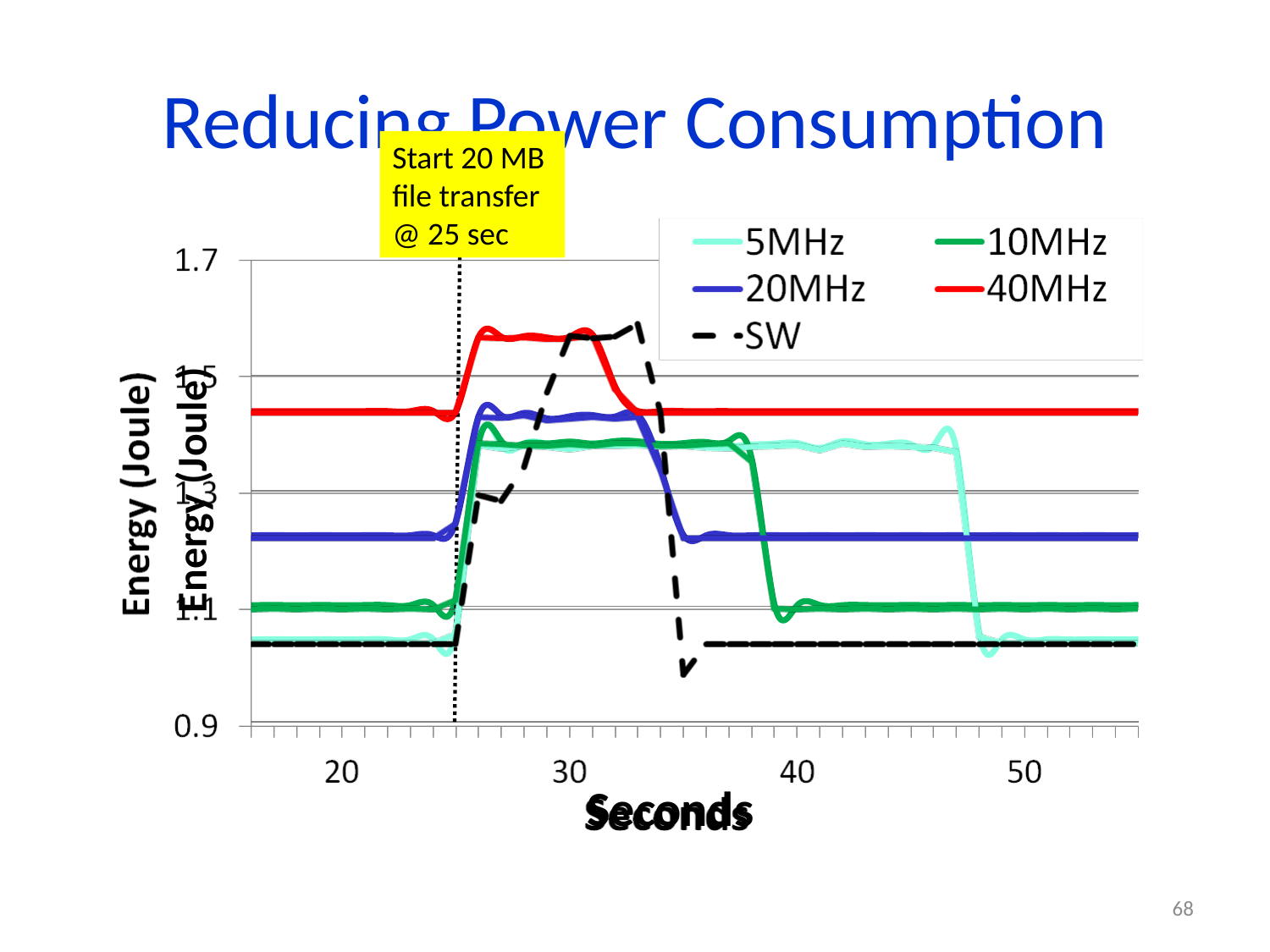
Before the file transfer starts (at 20 seconds), which series has the highest energy value? 40MHz At 20 seconds, is the value for 40MHz greater or less than 1.3? greater Which series are listed in the legend? 5MHz, 10MHz, 20MHz, 40MHz, SW At 20 seconds, is the value for 20MHz greater or less than 1.3? less Which series is the last to return to its pre-transfer level along the x axis? 5MHz At 20 seconds, which is larger, the value for 40MHz or the value for 20MHz? 40MHz According to the annotation, at what time does the 20 MB file transfer start? 25 sec How many series does the legend list? 5 How does the 40MHz series change between 25 and 28 seconds? rises At 20 seconds, is the value for 5MHz greater or less than 1.1? less What kind of chart is shown on the slide? line chart